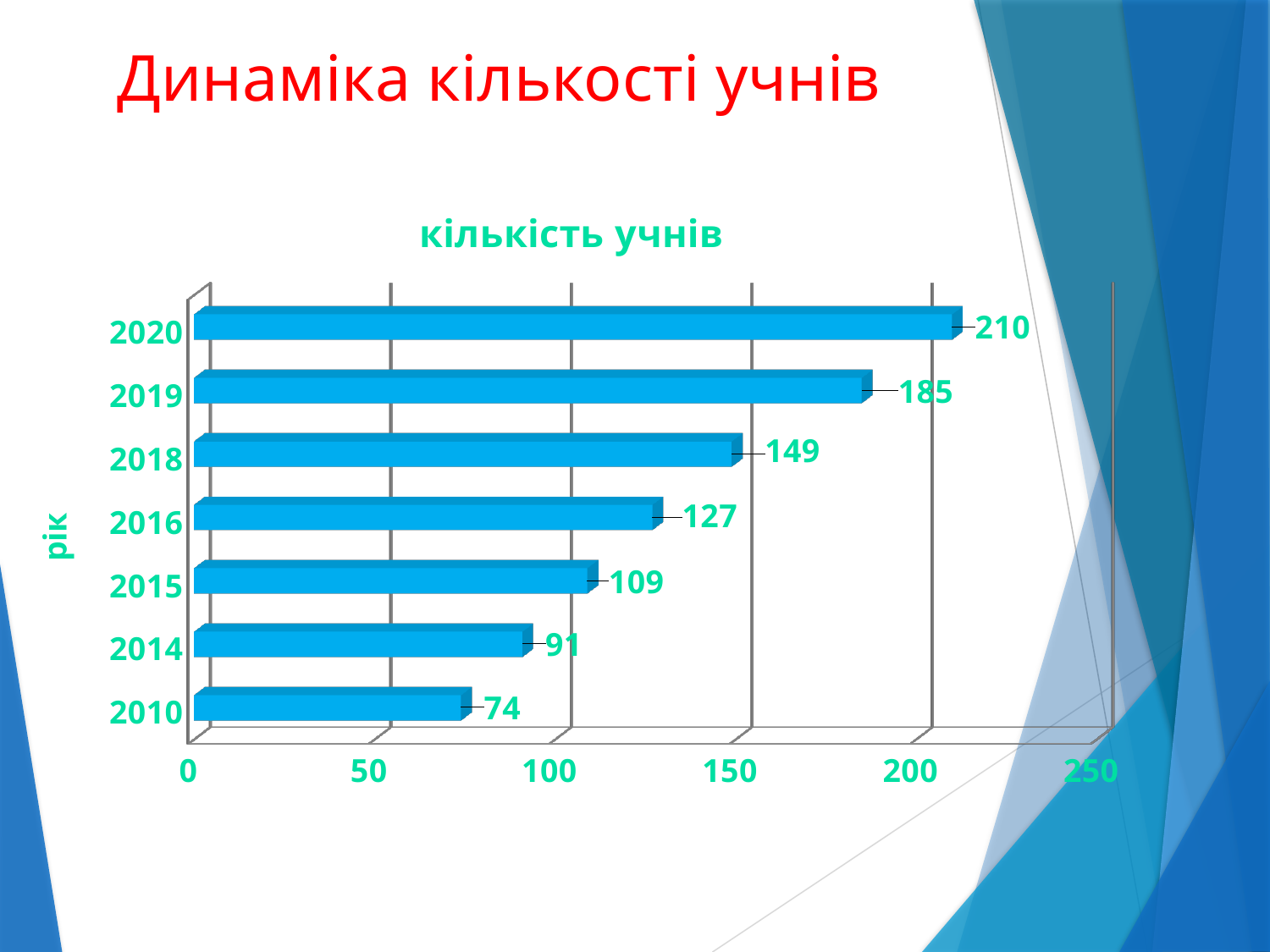
What is the difference in the number of students between 2020 and 2019? 25 What is the difference in the number of students between 2018 and 2014? 58 What is the title of the chart? кількість учнів How many years are shown in the chart? 7 What is the number of students for 2010? 74 Do the number of students rise or fall from 2010 to 2020? rise What is the number of students (кількість учнів) for 2020? 210 What is the number of students for 2016? 127 Which year has more students, 2015 or 2014? 2015 Which year has the highest number of students? 2020 What type of chart is shown on the slide? bar chart Which year has the lowest number of students? 2010